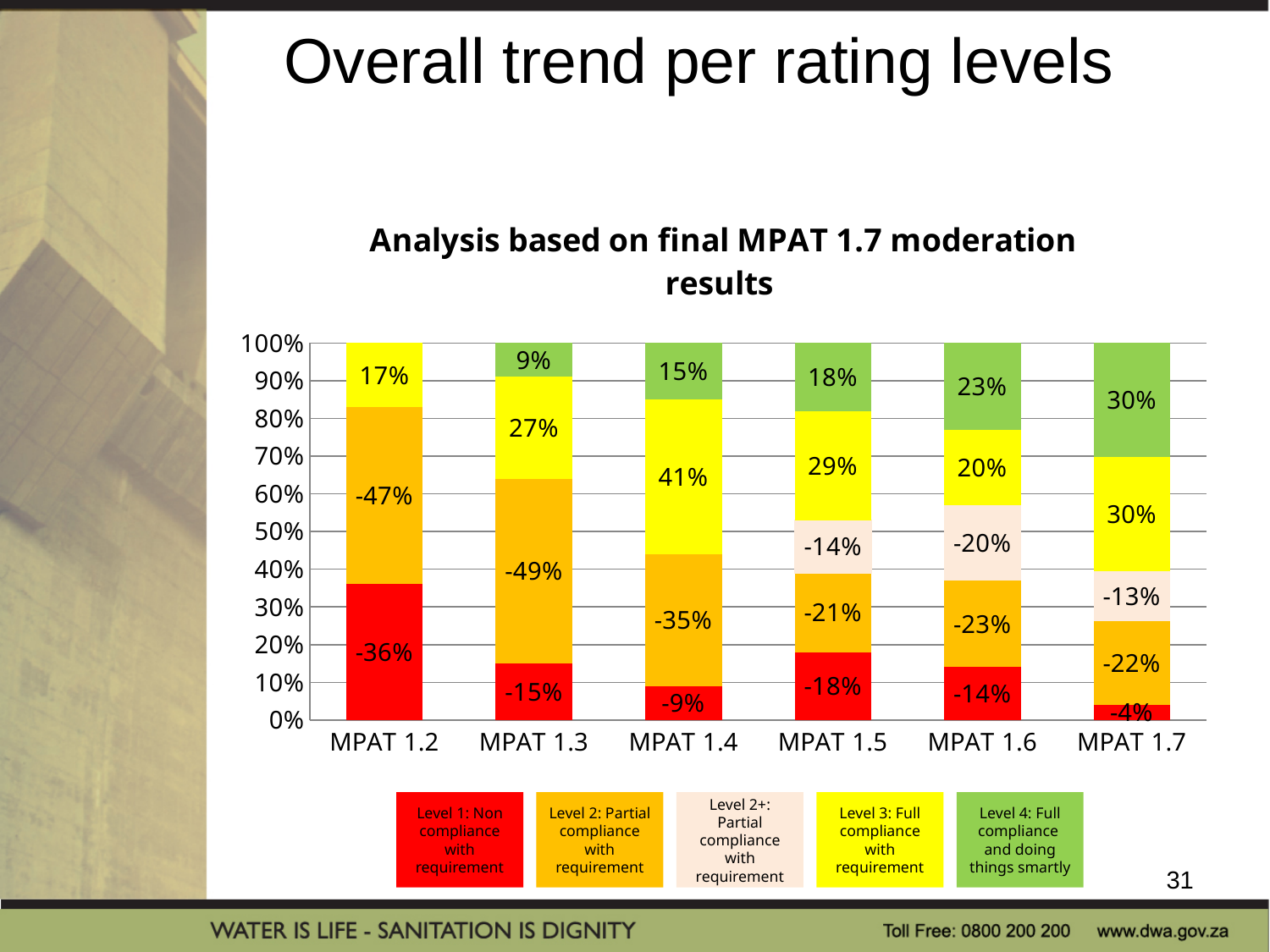
How many rating levels does the legend list? 5 What is the data label for Level 3 (Full compliance with requirement) in the MPAT 1.4 bar? 41% How many MPAT versions are shown on the x axis? 6 Which MPAT version has the largest Level 3 (Full compliance with requirement) segment? MPAT 1.4 Which MPAT version has the smallest Level 4 (Full compliance and doing things smartly) segment among those that show one? MPAT 1.3 Which has the larger Level 4 segment, MPAT 1.5 or MPAT 1.6? MPAT 1.6 What is the data label for Level 2+ (Partial compliance with requirement) in the MPAT 1.6 bar? -20% Does the Level 4 (green) segment rise or fall from MPAT 1.3 to MPAT 1.7? Rises What is the data label for Level 4 (Full compliance and doing things smartly) in the MPAT 1.7 bar? 30% What is the data label for Level 1 (Non compliance with requirement) in the MPAT 1.2 bar? -36% Which MPAT version has the largest Level 4 (Full compliance and doing things smartly) segment? MPAT 1.7 By how many percentage points does the Level 3 segment in MPAT 1.4 (41%) exceed the Level 3 segment in MPAT 1.3 (27%)? 14 percentage points